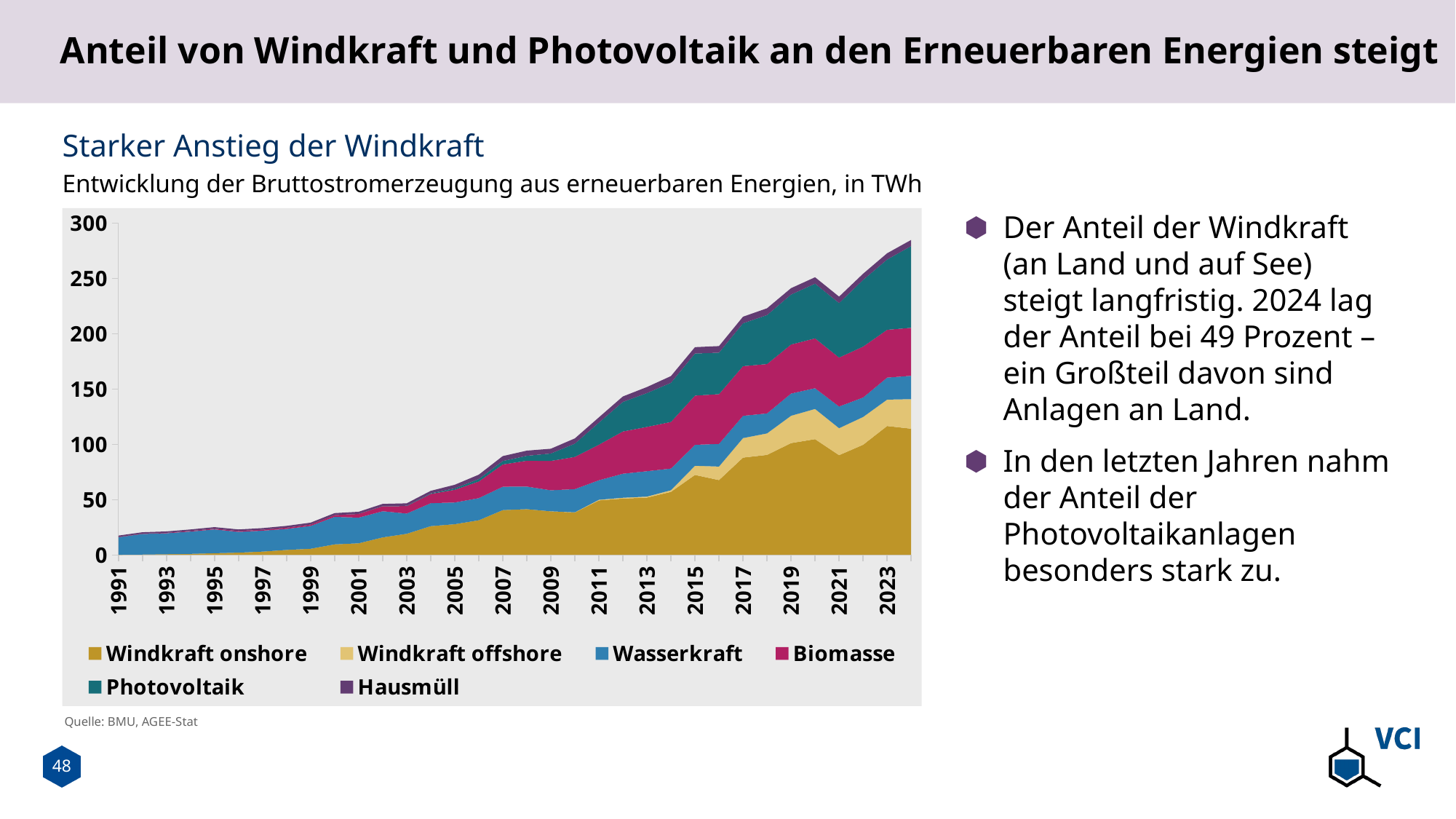
What unit is the chart's data given in, according to the subtitle? TWh Which series contributes the smallest share of the total in 2023? Hausmüll Is the value for Windkraft onshore in 2023 greater or less than 100? greater Which series contributes the largest share of the total in 2023? Windkraft onshore How many series does the chart legend list? 6 Which series are listed in the chart legend? Windkraft onshore, Windkraft offshore, Wasserkraft, Biomasse, Photovoltaik, Hausmüll What kind of chart is shown on the slide? stacked area chart In 2023, which is larger: Windkraft onshore or Wasserkraft? Windkraft onshore Is the total value for 1991 greater or less than 50? less Is the total value for 2023 greater or less than 250? greater Does the total gross electricity generation from renewables rise or fall from 1991 to 2023? rise